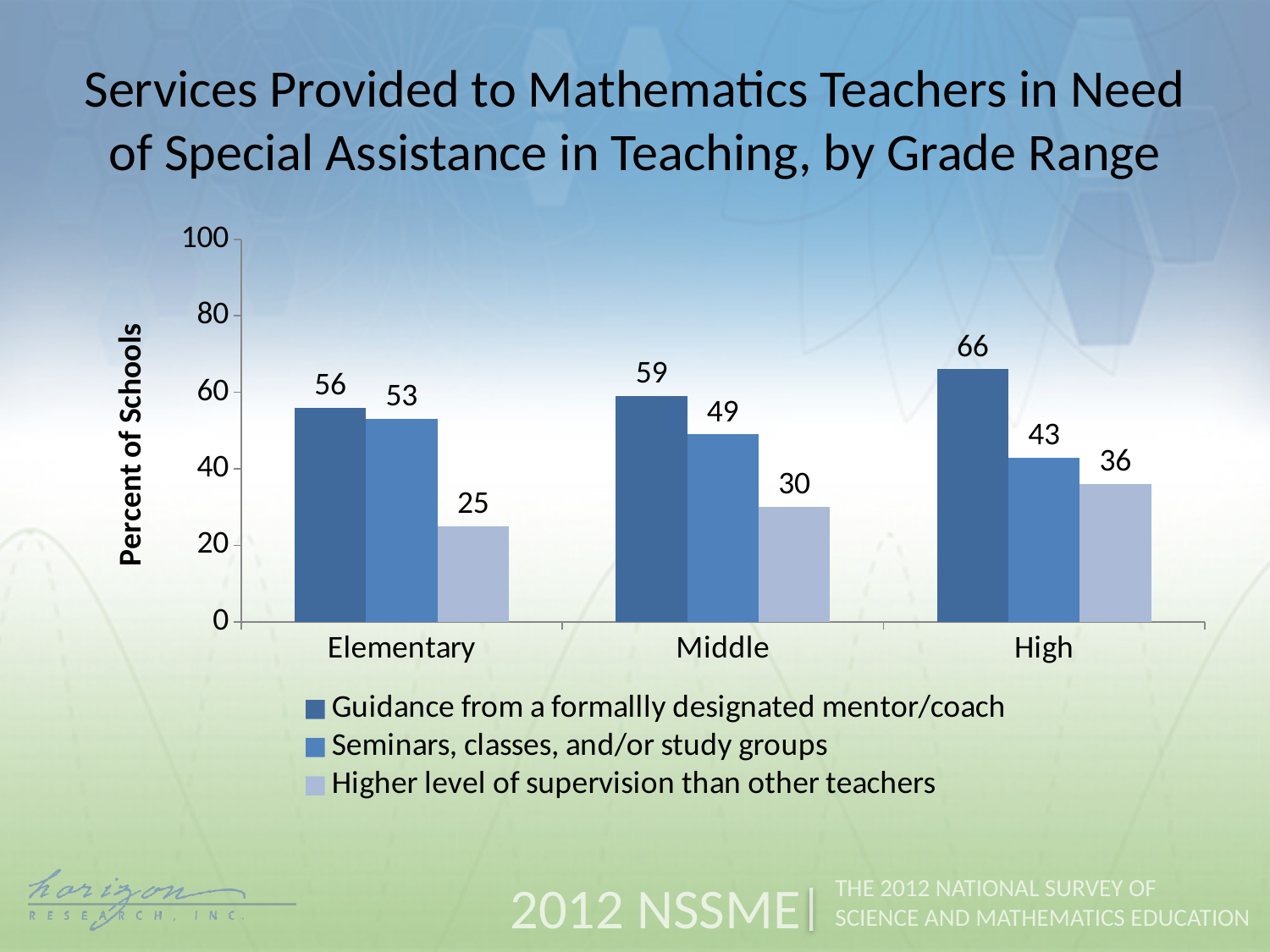
Which is larger: seminars, classes, and/or study groups at elementary schools or at high schools? Elementary Which grade range has the highest value for guidance from a formally designated mentor/coach? High What kind of chart is shown on the slide? Bar chart What is the value for seminars, classes, and/or study groups at middle schools? 49 What percent of elementary schools provide guidance from a formally designated mentor/coach? 56 What is the difference between the mentor/coach value and the higher supervision value for high schools? 30 What is the label of the y axis? Percent of Schools What percent of high schools provide a higher level of supervision than other teachers? 36 How many series does the legend list? 3 How many grade ranges are shown on the x axis? 3 Which grade range has the lowest value for higher level of supervision than other teachers? Elementary Do the values for guidance from a formally designated mentor/coach rise or fall from Elementary to High? Rise